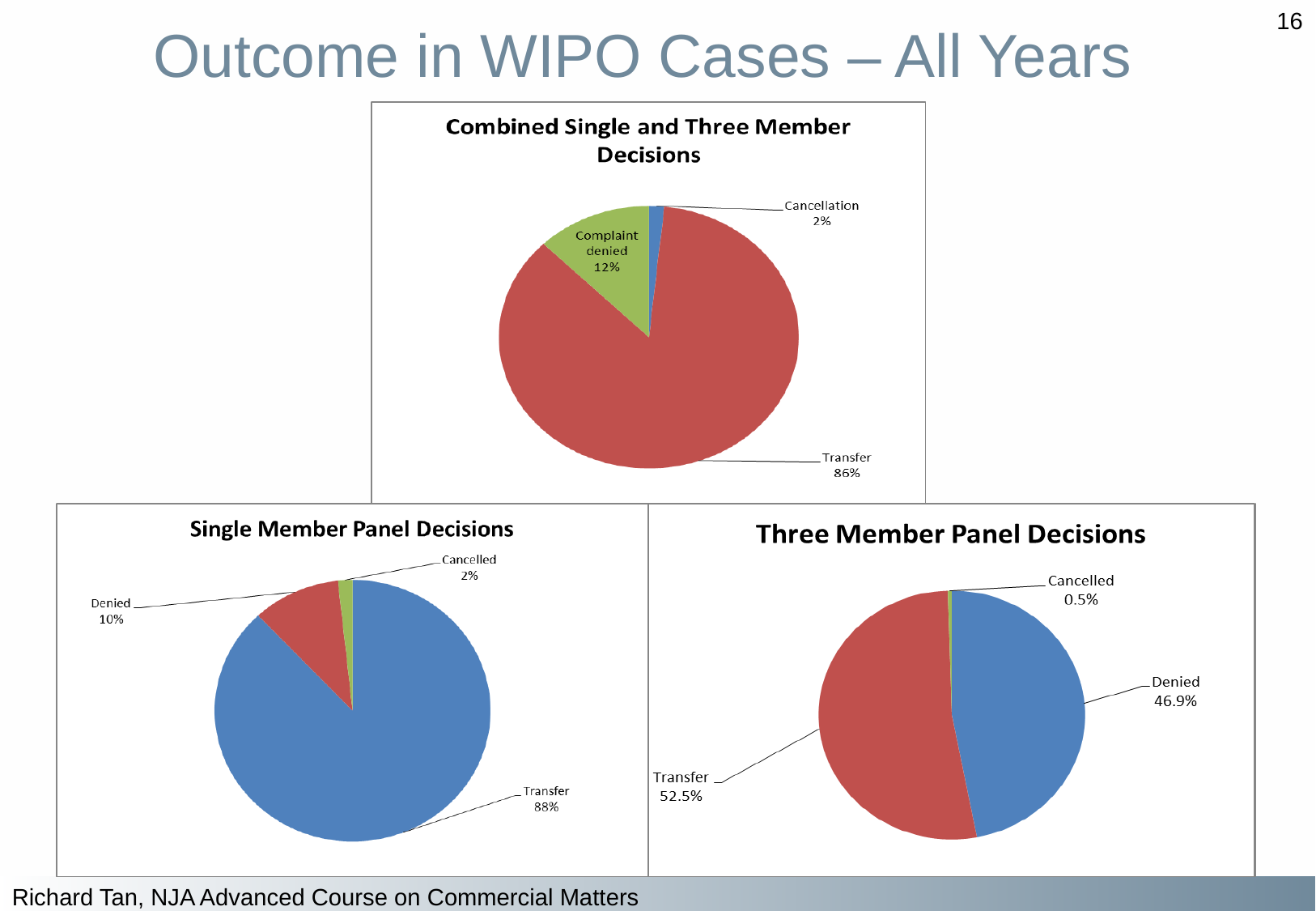
In the 'Single Member Panel Decisions' chart, what is the difference in percentage points between Transfer and Denied? 78 In the 'Combined Single and Three Member Decisions' chart, which outcome has the smallest slice? Cancellation In the 'Single Member Panel Decisions' chart, which outcome has the largest slice? Transfer How many charts are shown on the slide? 3 In the 'Combined Single and Three Member Decisions' chart, what share of cases resulted in Transfer? 86% How many slices does the 'Three Member Panel Decisions' chart have? 3 In the 'Three Member Panel Decisions' chart, what is the difference in percentage points between Transfer and Denied? 5.6 In the 'Three Member Panel Decisions' chart, which is larger, Transfer or Denied? Transfer What type of chart is used for 'Single Member Panel Decisions'? Pie chart In the 'Three Member Panel Decisions' chart, what percentage of cases were Cancelled? 0.5% In the 'Combined Single and Three Member Decisions' chart, what percentage is labelled 'Complaint denied'? 12% In the 'Single Member Panel Decisions' chart, what percentage of cases were Denied? 10%